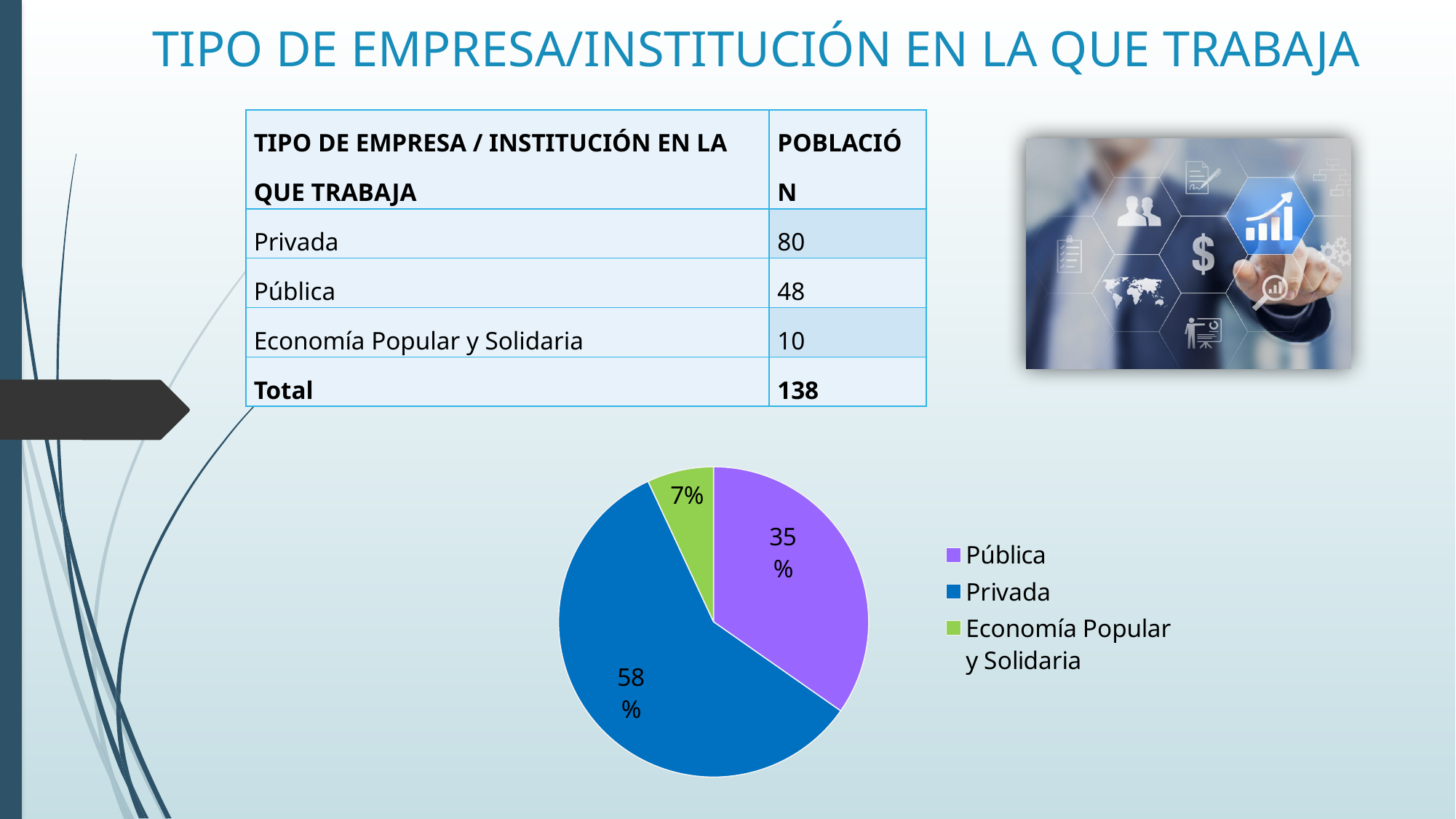
What colour is the Pública slice in the pie chart? purple What share of the pie does Economía Popular y Solidaria have? 7% How many slices does the pie chart have? 3 Which category has the smallest slice of the pie? Economía Popular y Solidaria How many entries does the legend list? 3 What colour is the Privada slice in the pie chart? blue What is the difference in percentage points between the Privada slice and the Pública slice? 23 Which category has the largest slice of the pie? Privada Which is larger, the slice for Pública or the slice for Economía Popular y Solidaria? Pública What kind of chart is shown on the slide? pie chart What share of the pie does Pública have? 35% What share of the pie does Privada have? 58%